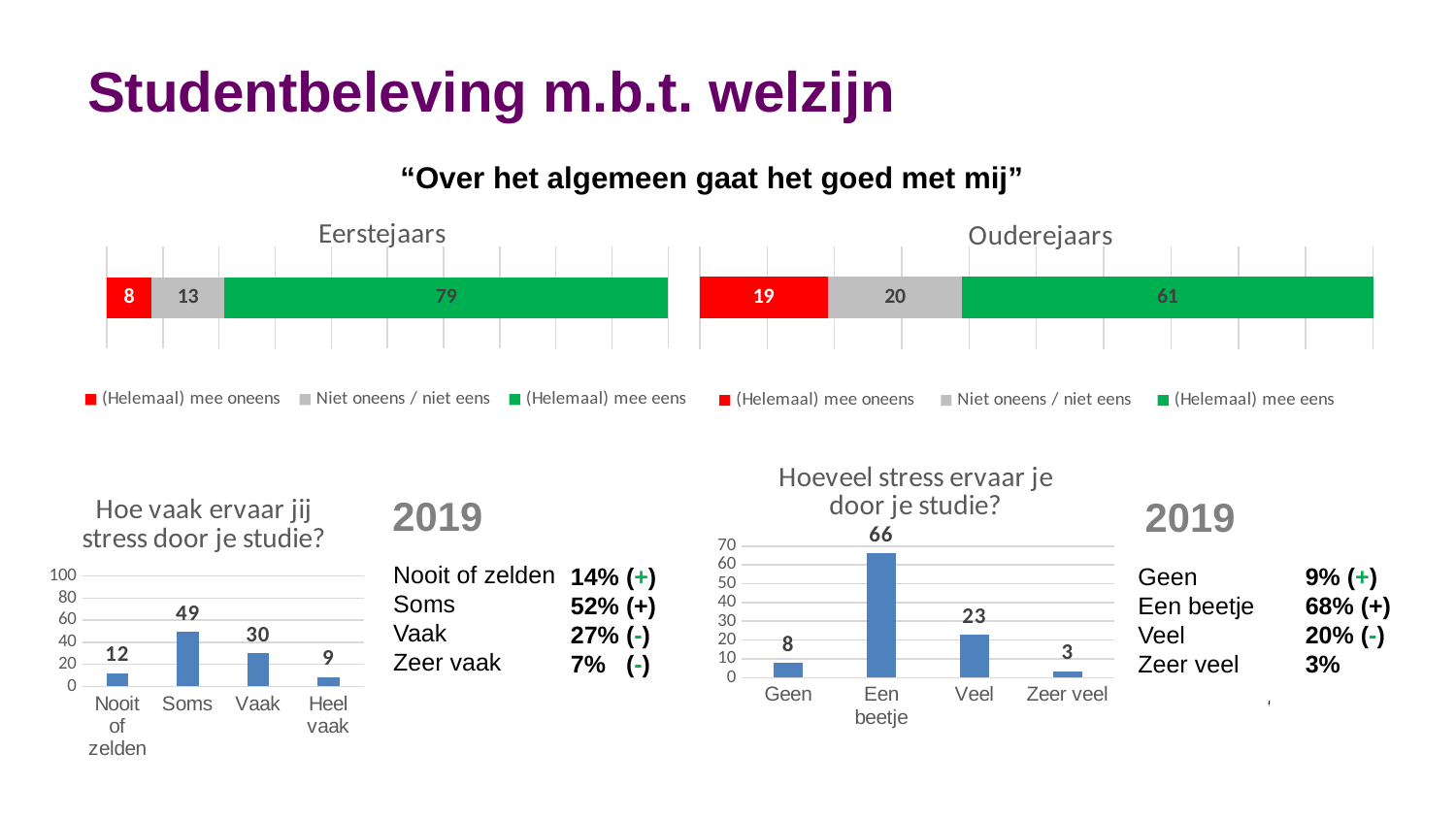
In the 'Hoeveel stress ervaar je door je studie?' chart, what is the value for 'Veel'? 23 In the 'Hoeveel stress ervaar je door je studie?' chart, which category has the highest value? Een beetje In the 'Hoe vaak ervaar jij stress door je studie?' chart, which category has the lowest value? Heel vaak What kind of chart is the 'Hoeveel stress ervaar je door je studie?' chart? Bar chart In the 'Ouderejaars' chart, what is the value for '(Helemaal) mee oneens'? 19 How many series does the legend of the 'Eerstejaars' chart list? 3 In the 'Hoeveel stress ervaar je door je studie?' chart, how many categories are shown on the x axis? 4 What is the difference between the '(Helemaal) mee eens' values in the 'Eerstejaars' and 'Ouderejaars' charts? 18 In the 'Ouderejaars' chart, what is the total of the stacked bar? 100 In the 'Hoe vaak ervaar jij stress door je studie?' chart, what is the difference between 'Soms' and 'Vaak'? 19 In the 'Eerstejaars' chart, what is the value for '(Helemaal) mee eens'? 79 In the 'Hoe vaak ervaar jij stress door je studie?' chart, what is the value for 'Soms'? 49